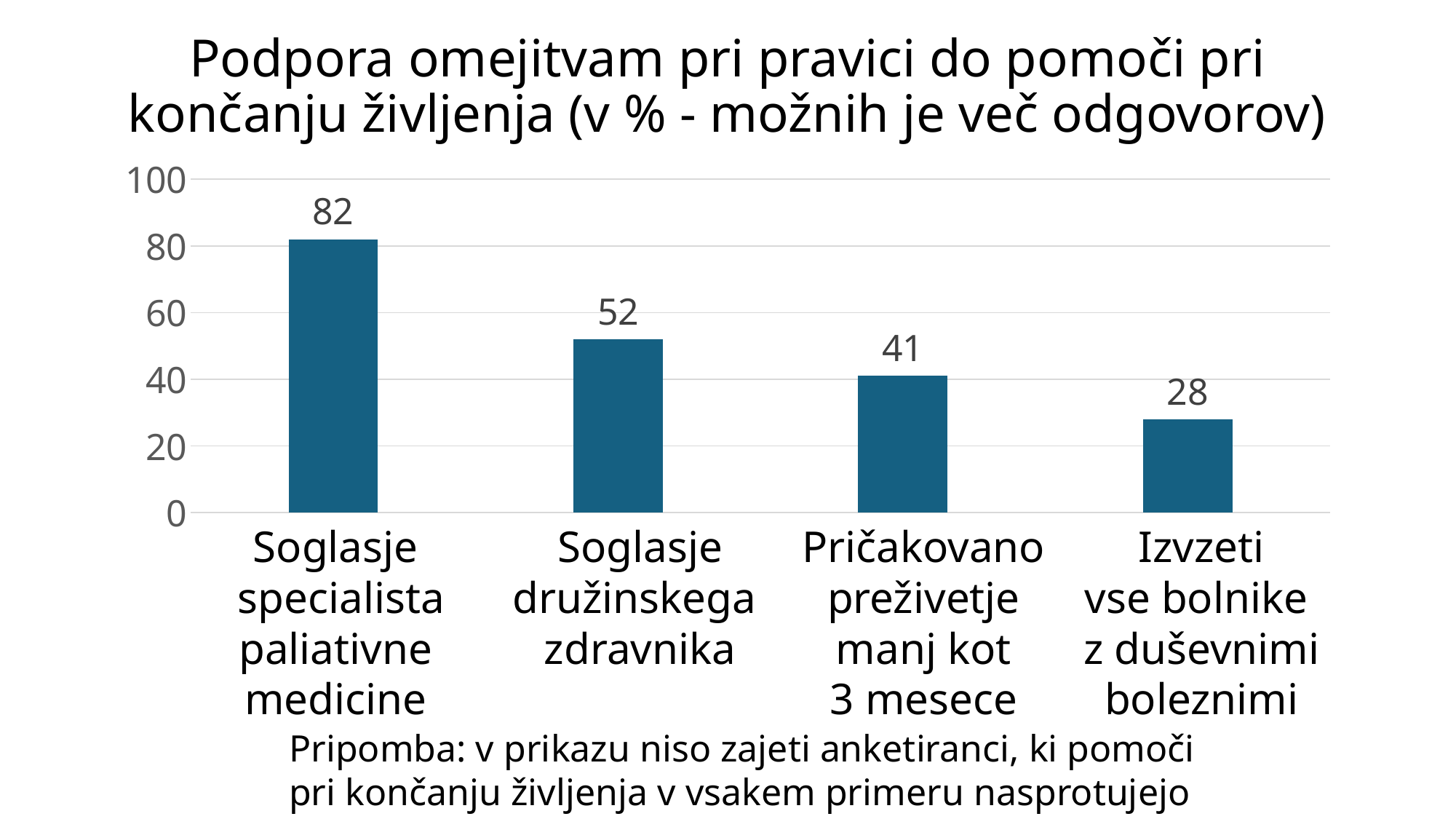
What kind of chart is shown on the slide? Bar chart Do the values rise or fall from left to right along the x axis? Fall What is the value for "Izvzeti vse bolnike z duševnimi boleznimi"? 28 What is the value for "Pričakovano preživetje manj kot 3 mesece"? 41 What is the difference between the values for "Pričakovano preživetje manj kot 3 mesece" and "Izvzeti vse bolnike z duševnimi boleznimi"? 13 Which category has the lowest value? Izvzeti vse bolnike z duševnimi boleznimi What is the value for "Soglasje specialista paliativne medicine"? 82 Which is larger: the value for "Soglasje družinskega zdravnika" or for "Pričakovano preživetje manj kot 3 mesece"? Soglasje družinskega zdravnika What is the value for "Soglasje družinskega zdravnika"? 52 How many categories are shown in the chart? 4 What is the difference between the values for "Soglasje specialista paliativne medicine" and "Soglasje družinskega zdravnika"? 30 Which category has the highest value? Soglasje specialista paliativne medicine